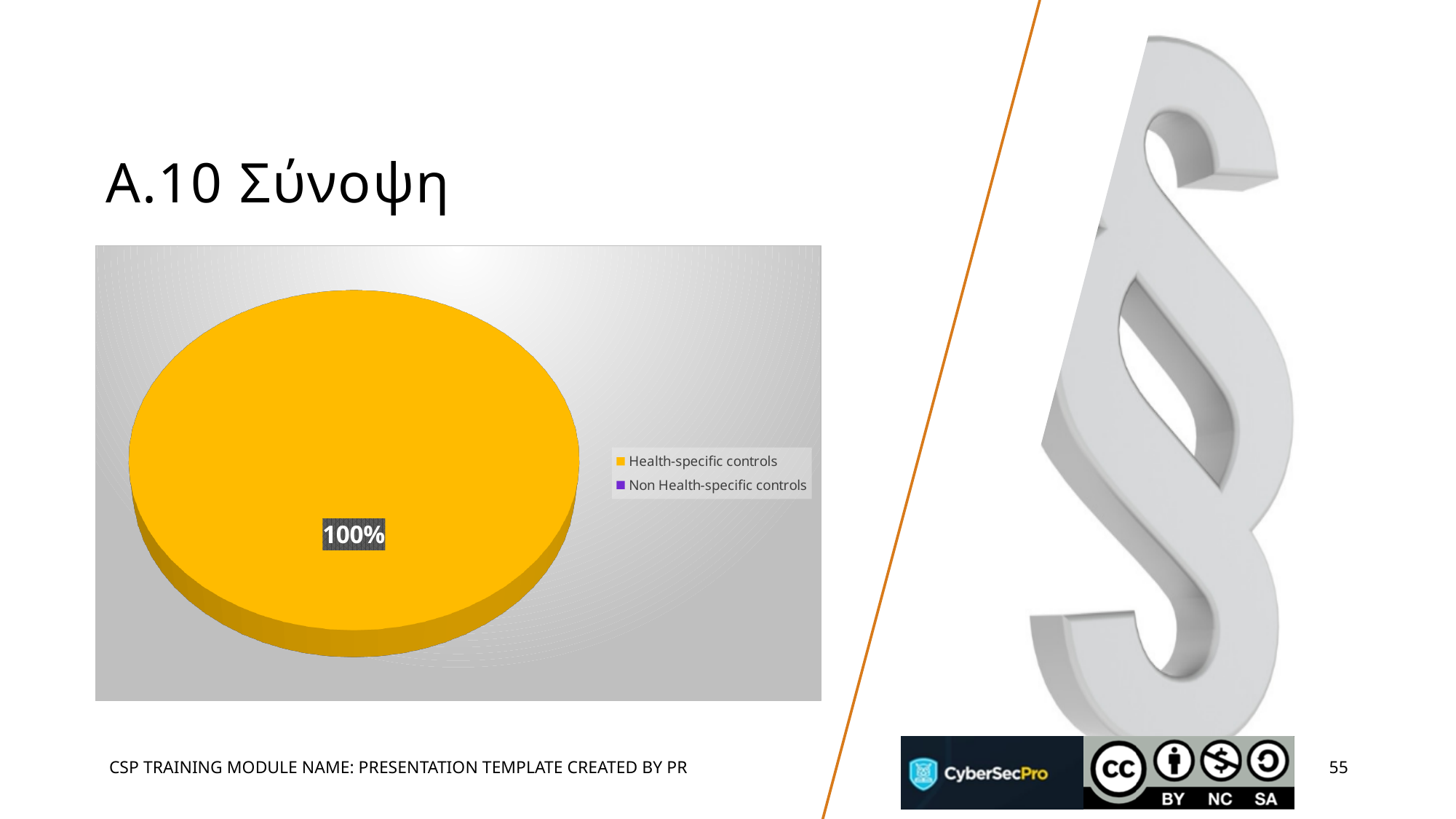
How many entries does the legend of the pie chart list? 2 Which category has the smallest share in the pie chart? Non Health-specific controls Is the share for Health-specific controls greater or less than 50%? greater How many data labels are printed on the pie chart? 1 What percentage is shown for Health-specific controls in the pie chart? 100% What colour represents Non Health-specific controls in the pie chart legend? purple Which category has the largest share in the pie chart? Health-specific controls What kind of chart is shown on the slide? pie chart Which is larger in the pie chart, Health-specific controls or Non Health-specific controls? Health-specific controls What colour represents Health-specific controls in the pie chart legend? yellow What share of the pie does the Health-specific controls slice take? 100%